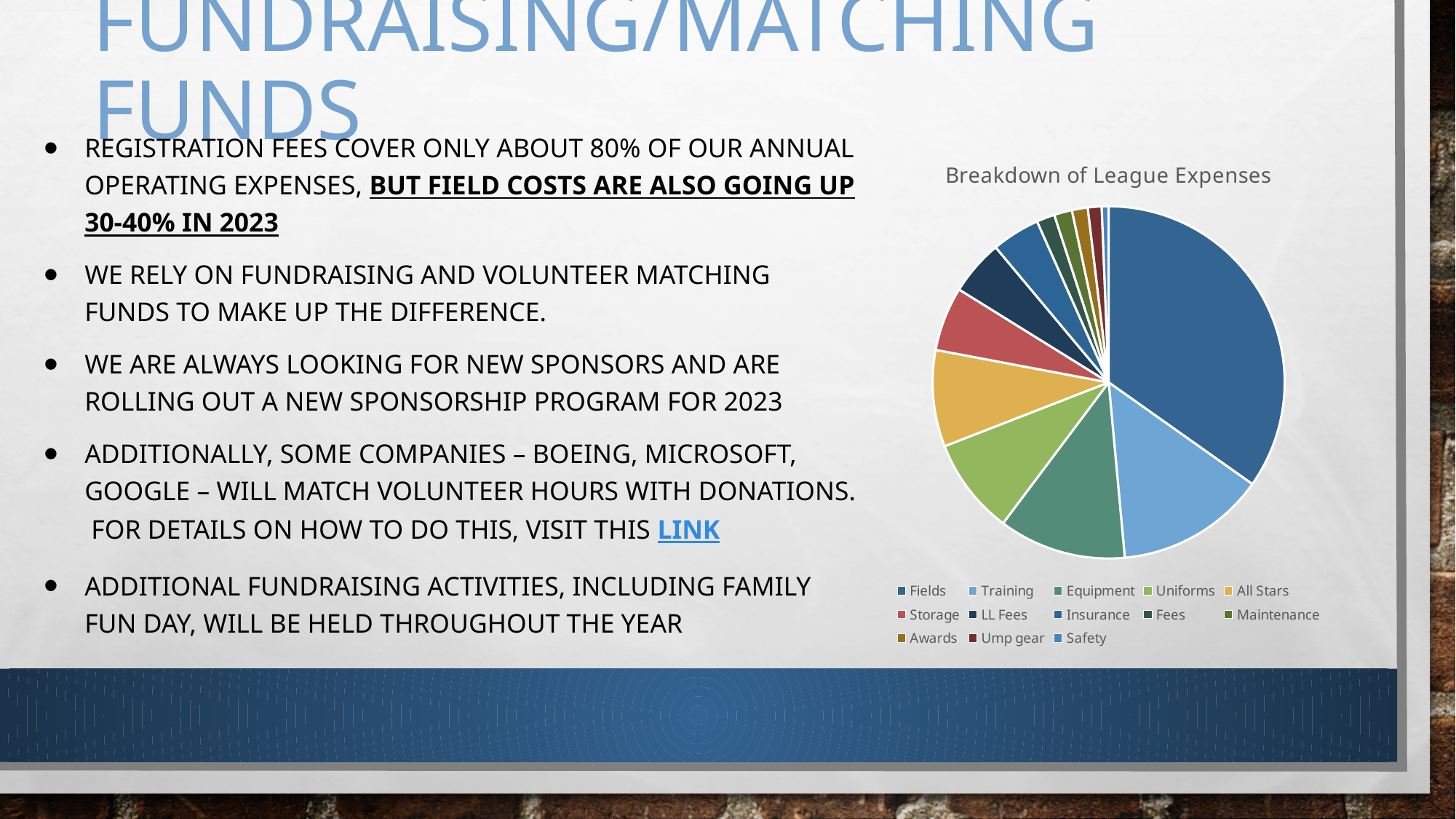
Which slice is larger in the pie chart, Fields or Training? Fields What kind of chart is shown on the slide? pie chart Which slice is larger in the pie chart, Uniforms or Storage? Uniforms Which slice is larger in the pie chart, Training or LL Fees? Training What is the first category listed in the pie chart's legend? Fields Which expense category is the smallest slice of the pie chart? Safety Which expense category is the largest slice of the pie chart? Fields What is the title of the chart on the slide? Breakdown of League Expenses How many expense categories does the pie chart's legend list? 13